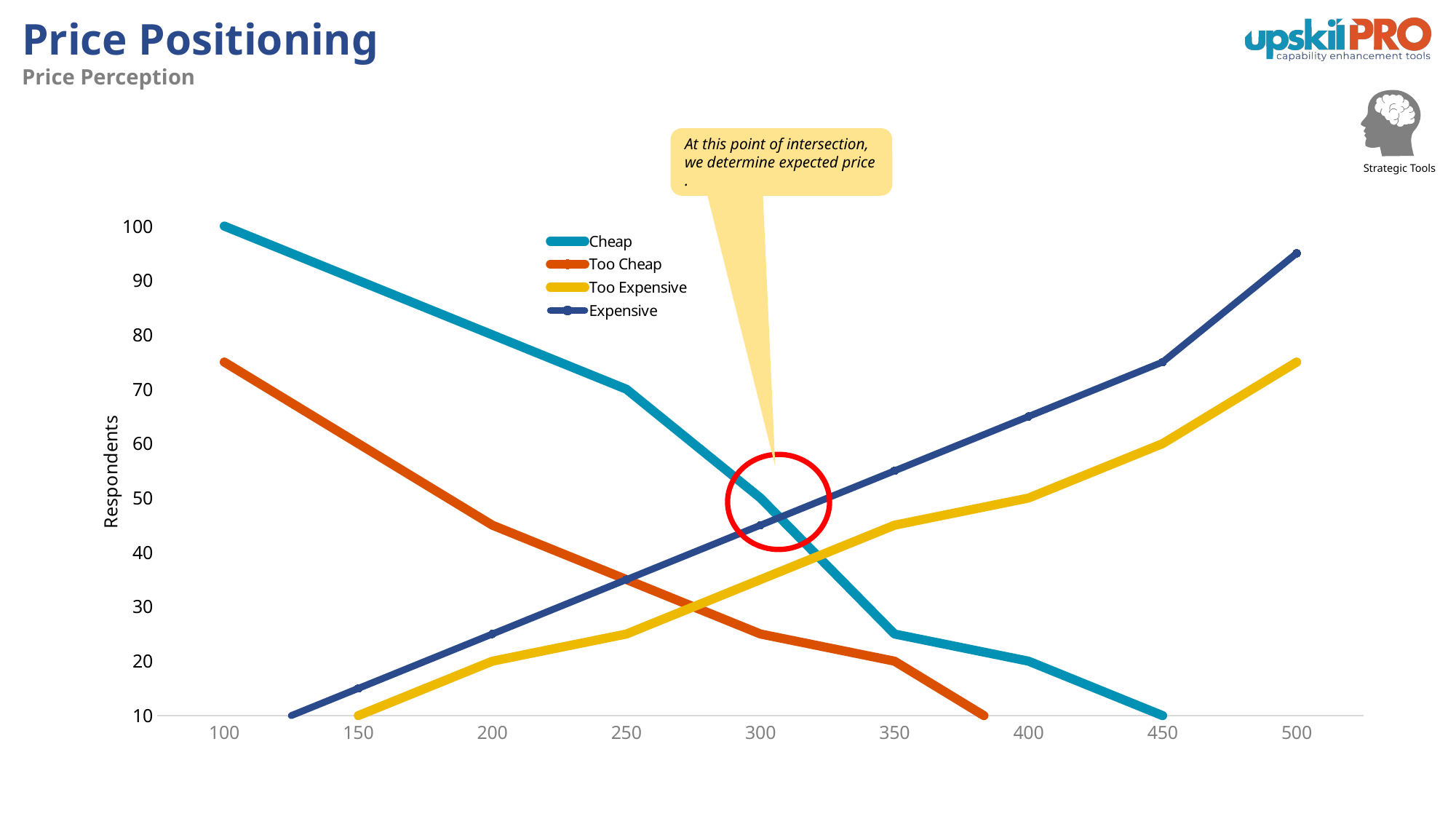
Do the values of the Cheap series rise or fall as price increases along the x axis? fall What is the label on the vertical axis of the chart? Respondents What is the value of the Too Expensive series at a price of 400? 50 Is the value of the Too Cheap series at a price of 100 greater or less than 70? greater Is the value of the Expensive series at a price of 500 greater or less than 90? greater What is the value of the Too Cheap series at a price of 350? 20 What kind of chart is shown on the slide? line chart Do the values of the Expensive series rise or fall as price increases along the x axis? rise At a price of 500, which series has the larger value: Expensive or Too Expensive? Expensive What is the value of the Cheap series at a price of 100? 100 What is the value of the Cheap series at a price of 450? 10 How many series does the legend list? 4